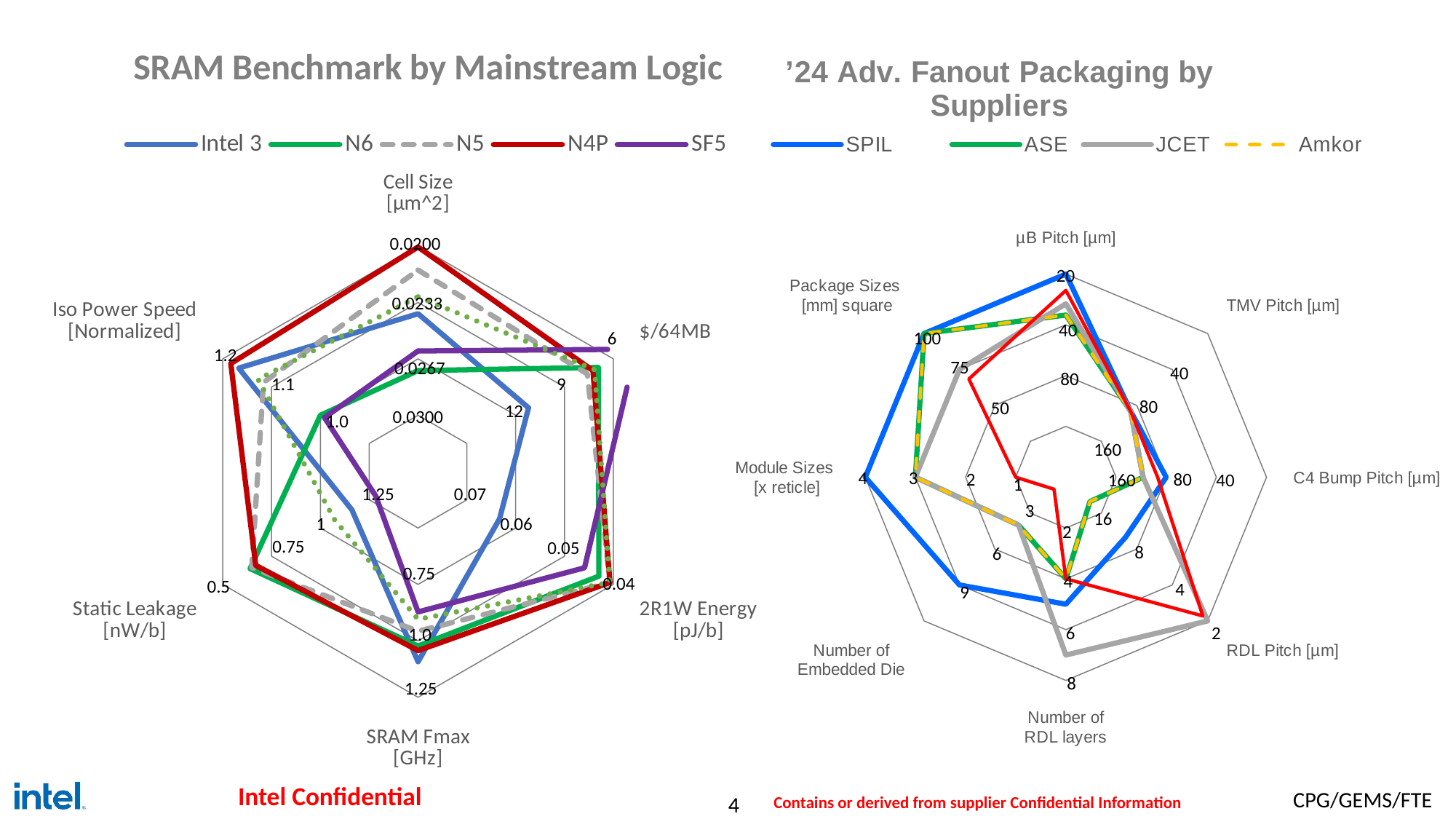
On the 'SRAM Benchmark by Mainstream Logic' chart, which series is drawn with a dashed grey line? N5 On the ''24 Adv. Fanout Packaging by Suppliers' chart, how many series does the legend list? 4 On the ''24 Adv. Fanout Packaging by Suppliers' chart, is the value for SPIL on the Package Sizes axis greater or less than 75? greater On the ''24 Adv. Fanout Packaging by Suppliers' chart, which series is drawn with a dashed yellow line? Amkor What kind of chart is the 'SRAM Benchmark by Mainstream Logic' chart? radar chart On the 'SRAM Benchmark by Mainstream Logic' chart, how many series does the legend list? 5 On the ''24 Adv. Fanout Packaging by Suppliers' chart, is the value for JCET on the Number of RDL layers axis greater or less than 6? greater On the ''24 Adv. Fanout Packaging by Suppliers' chart, is the value for Amkor on the Number of Embedded Die axis greater or less than 6? less What kind of chart is the ''24 Adv. Fanout Packaging by Suppliers' chart? radar chart On the ''24 Adv. Fanout Packaging by Suppliers' chart, how many axes (categories) are plotted? 8 On the 'SRAM Benchmark by Mainstream Logic' chart, how many axes (categories) are plotted? 6